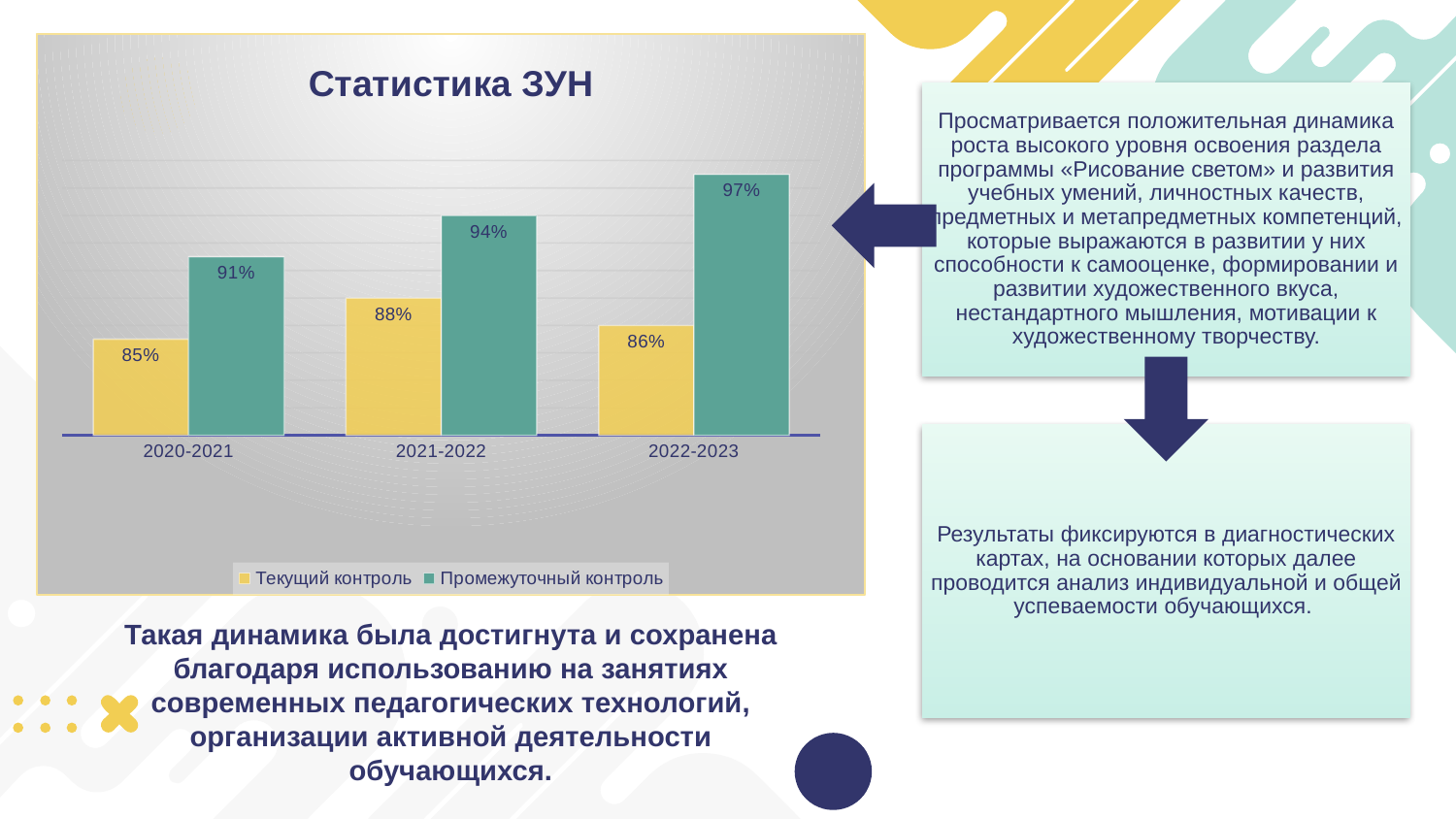
Which year has the lowest value for Текущий контроль? 2020-2021 What is the value of Промежуточный контроль for 2022-2023? 97% What is the difference between Промежуточный контроль and Текущий контроль in 2022-2023? 11% What is the value of Текущий контроль for 2021-2022? 88% Which year has the highest value for Промежуточный контроль? 2022-2023 How many year categories are shown on the x axis? 3 What is the value of Текущий контроль for 2020-2021? 85% What kind of chart is shown? Bar chart Do the values for Промежуточный контроль rise or fall from 2020-2021 to 2022-2023? Rise Which is larger in 2021-2022: Текущий контроль or Промежуточный контроль? Промежуточный контроль How many series does the legend list? 2 What is the title of the chart? Статистика ЗУН